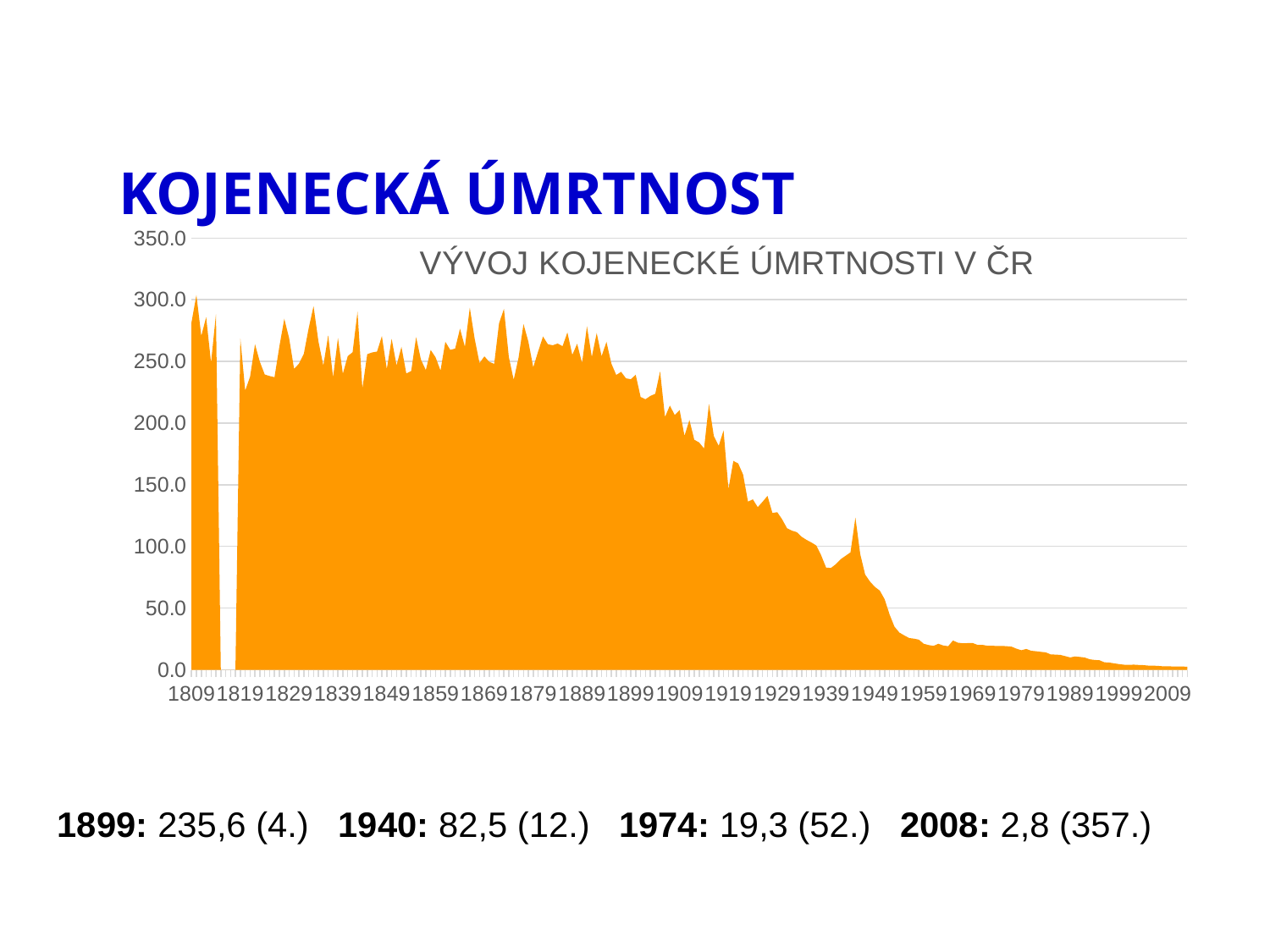
What kind of chart is shown on the slide? area chart Is the value for 1899 greater or less than 200? greater Which year has the larger value, 1899 or 1949? 1899 Is the value for 1949 greater or less than 100? less Is the value for 1979 greater or less than 50? less Which year has the larger value, 1859 or 1999? 1859 What is the title of the chart? VÝVOJ KOJENECKÉ ÚMRTNOSTI V ČR How many year labels are shown on the x axis? 21 What is the highest value shown on the y axis? 350.0 Overall, do the values rise or fall along the x axis from 1809 to 2009? fall